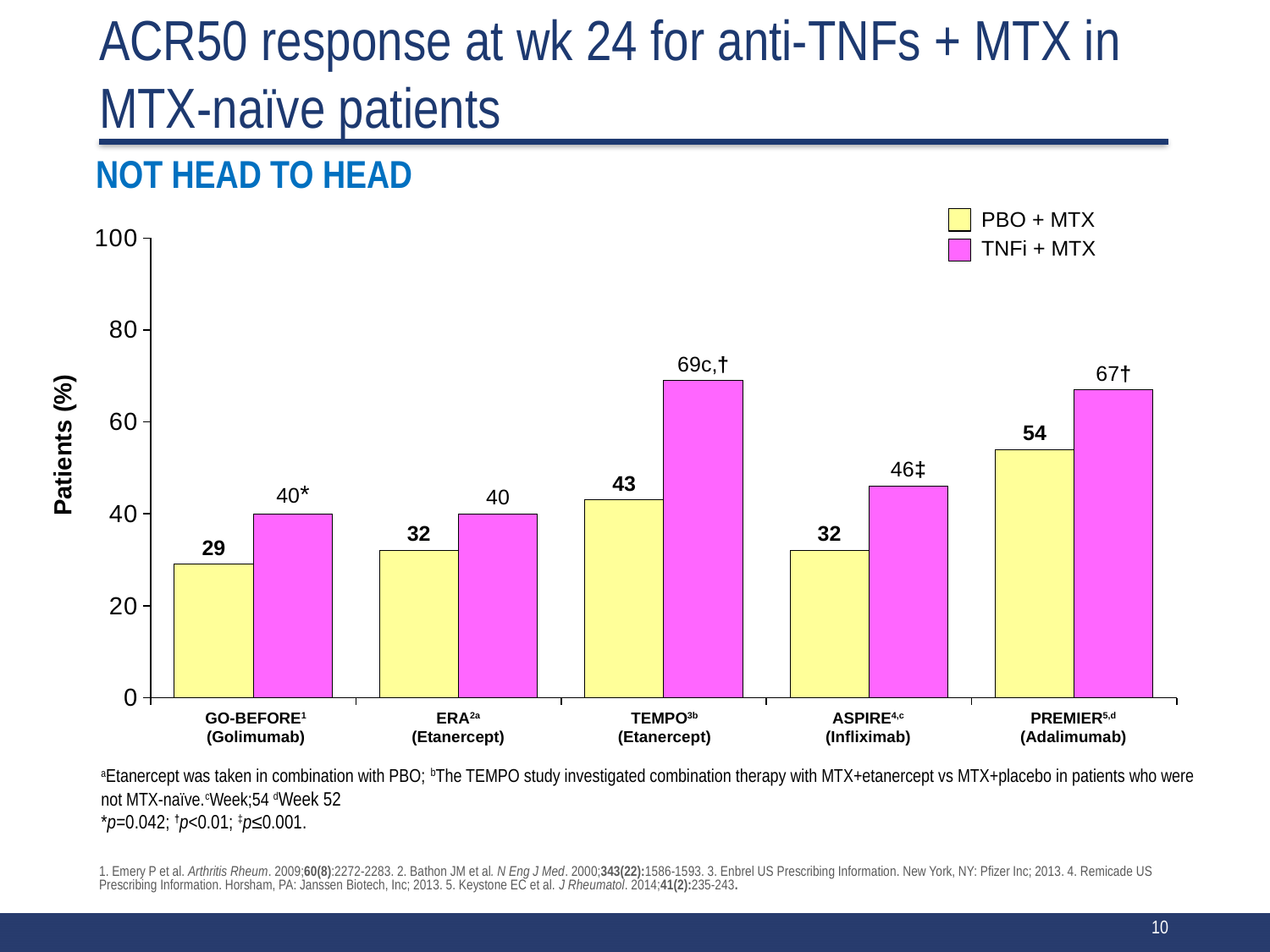
Which study has the lowest PBO + MTX value? GO-BEFORE (Golimumab) What kind of chart is shown on the slide? Bar chart How many series does the legend list? 2 What is the difference between the TNFi + MTX and PBO + MTX values for TEMPO (Etanercept)? 26 What is the PBO + MTX value for PREMIER (Adalimumab)? 54 How many studies are shown on the x axis? 5 What is the PBO + MTX value for GO-BEFORE (Golimumab)? 29 What is the PBO + MTX value for TEMPO (Etanercept)? 43 What is the TNFi + MTX value for ERA (Etanercept)? 40 Which is larger for PREMIER (Adalimumab): the PBO + MTX value or the TNFi + MTX value? TNFi + MTX Is the TNFi + MTX value for ASPIRE (Infliximab) greater or less than 40? greater Which study has the highest TNFi + MTX value? TEMPO (Etanercept)